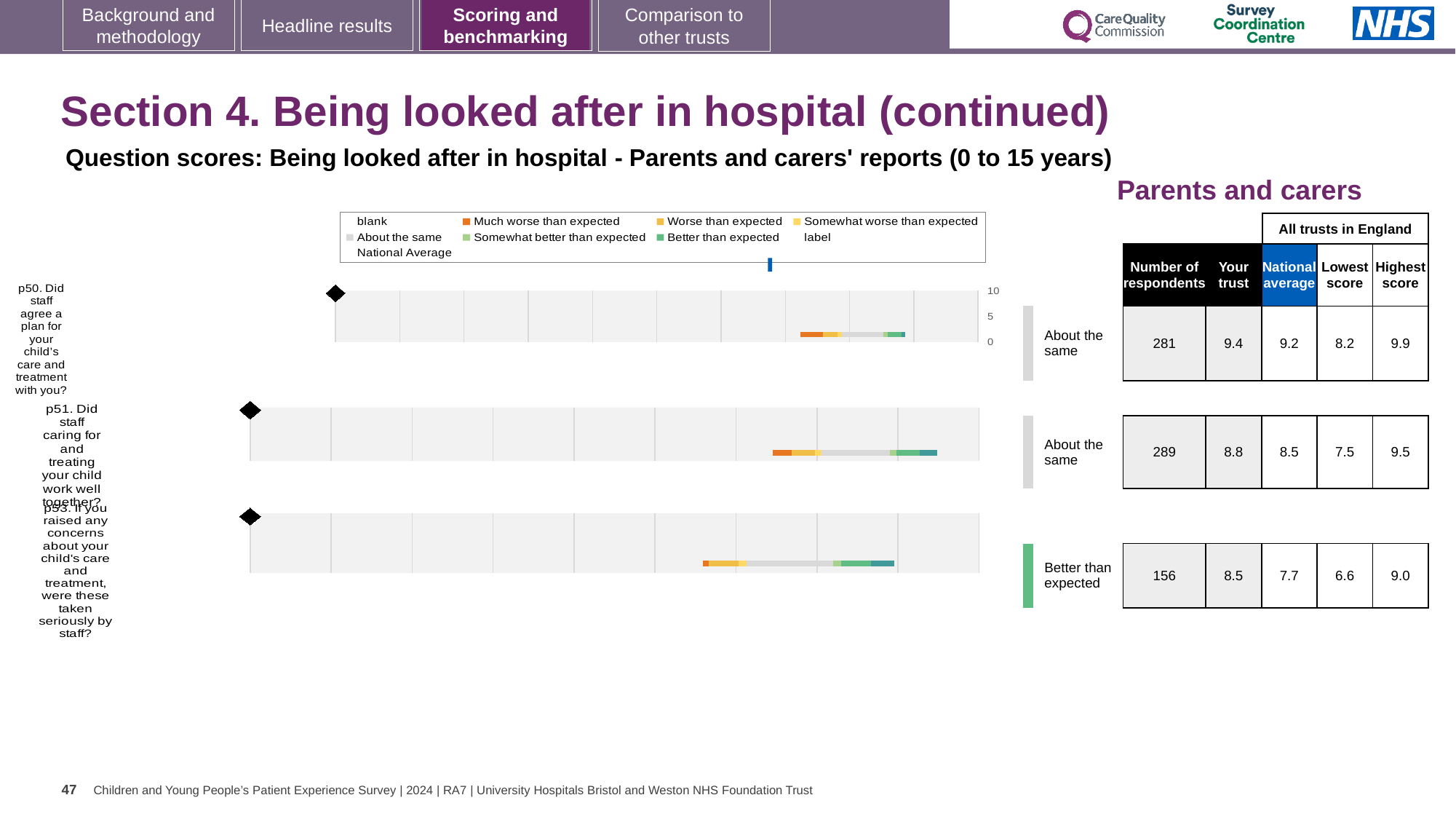
What kind of chart is used for each question on this slide? Bar chart Which question has the highest 'Your trust' score? p50 How many respondents answered p53 (If you raised any concerns about your child's care and treatment, were these taken seriously by staff)? 156 Which question has the lowest 'Your trust' score? p53 For p51, which is larger: the 'Your trust' score or the national average? Your trust (8.8) What is the national average score for p51 (Did staff caring for and treating your child work well together)? 8.5 What is the difference between the 'Your trust' score and the national average for p53? 0.8 What benchmark category is shown for p53? Better than expected What is the difference between the 'Your trust' score and the national average for p50? 0.2 What is the 'Your trust' score for p50 (Did staff agree a plan for your child's care and treatment with you)? 9.4 How many questions are charted on this slide? 3 What is the highest score among all trusts in England for p51? 9.5